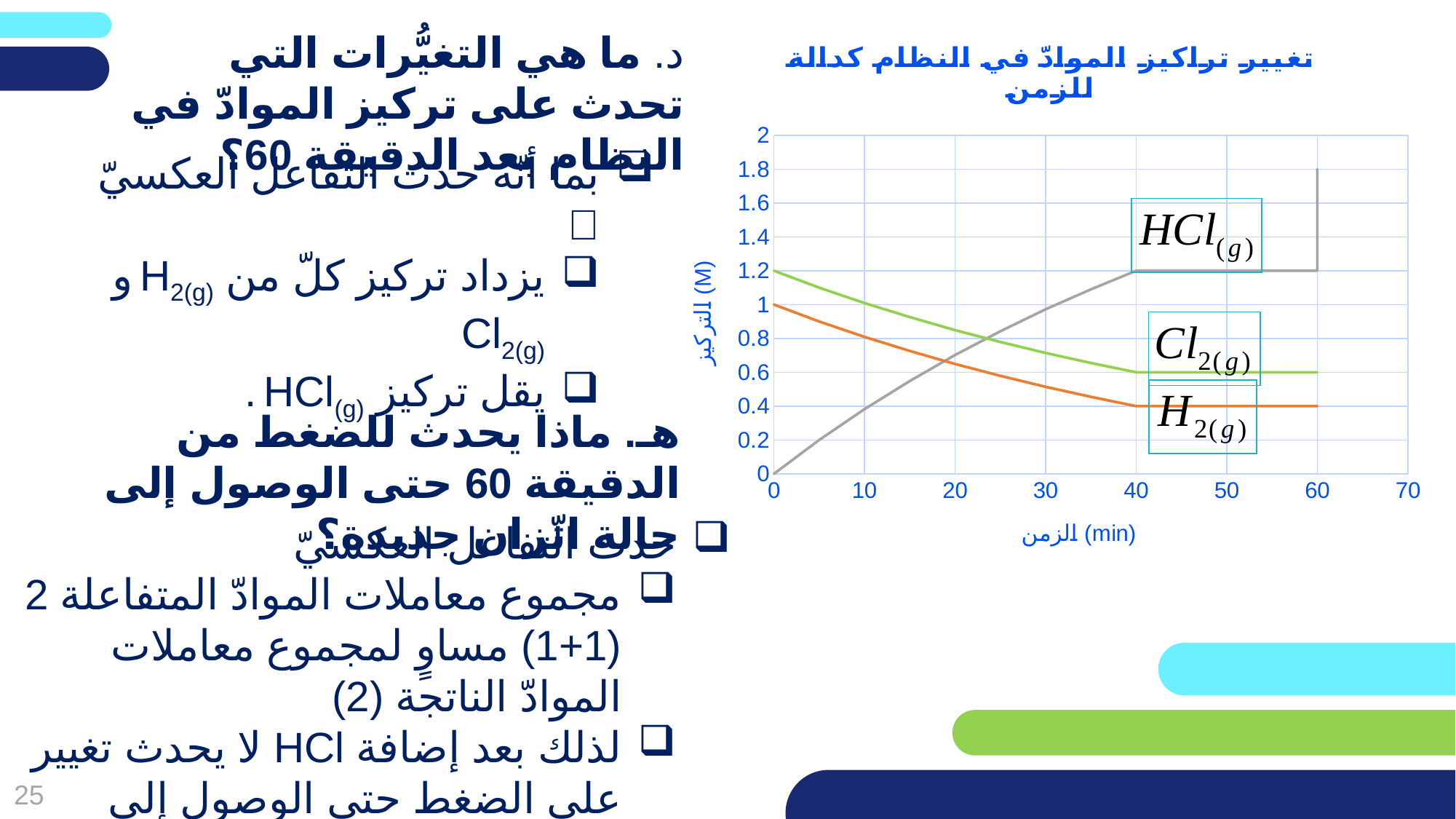
What kind of chart is shown on the slide? line chart Does the concentration of Cl2(g) rise or fall between 0 and 40 min? fall How many series are plotted on the chart? 3 What is the concentration of Cl2(g) at time 0 min? 1.2 Is the concentration of H2(g) at 50 min greater or less than 0.6? less At 10 min, which is larger: the concentration of Cl2(g) or of HCl(g)? Cl2(g) Does the concentration of HCl(g) rise or fall between 0 and 40 min? rise What is the label of the x axis? الزمن (min) What is the concentration of H2(g) at time 0 min? 1 Which series has the highest concentration at 50 min? HCl(g) What is the concentration of HCl(g) at time 0 min? 0 Is the concentration of HCl(g) at 50 min greater or less than 1? greater